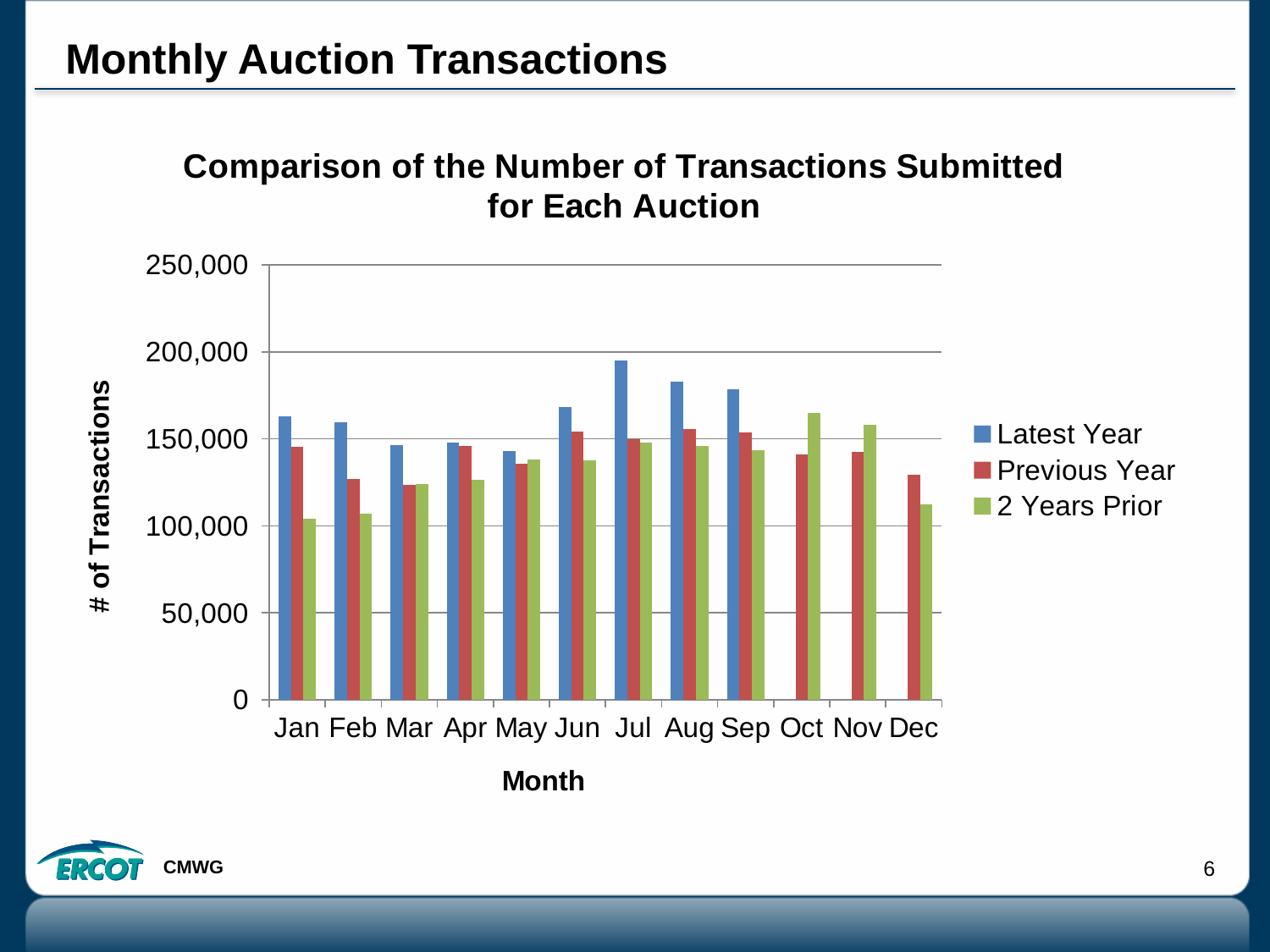
What kind of chart is shown on the slide? bar chart How many months have a Latest Year bar? 9 What is the title of the y axis? # of Transactions How many months are shown on the x axis? 12 In which month is the 2 Years Prior value highest? Oct In which month is the Latest Year value highest? Jul How many series does the legend list? 3 For Oct, which is larger: the Previous Year value or the 2 Years Prior value? 2 Years Prior Is the Latest Year value for Jul greater or less than 200,000? less Is the Latest Year value for Jul greater or less than 150,000? greater Is the 2 Years Prior value for Jan greater or less than 150,000? less For Jan, which is larger: the Latest Year value or the 2 Years Prior value? Latest Year